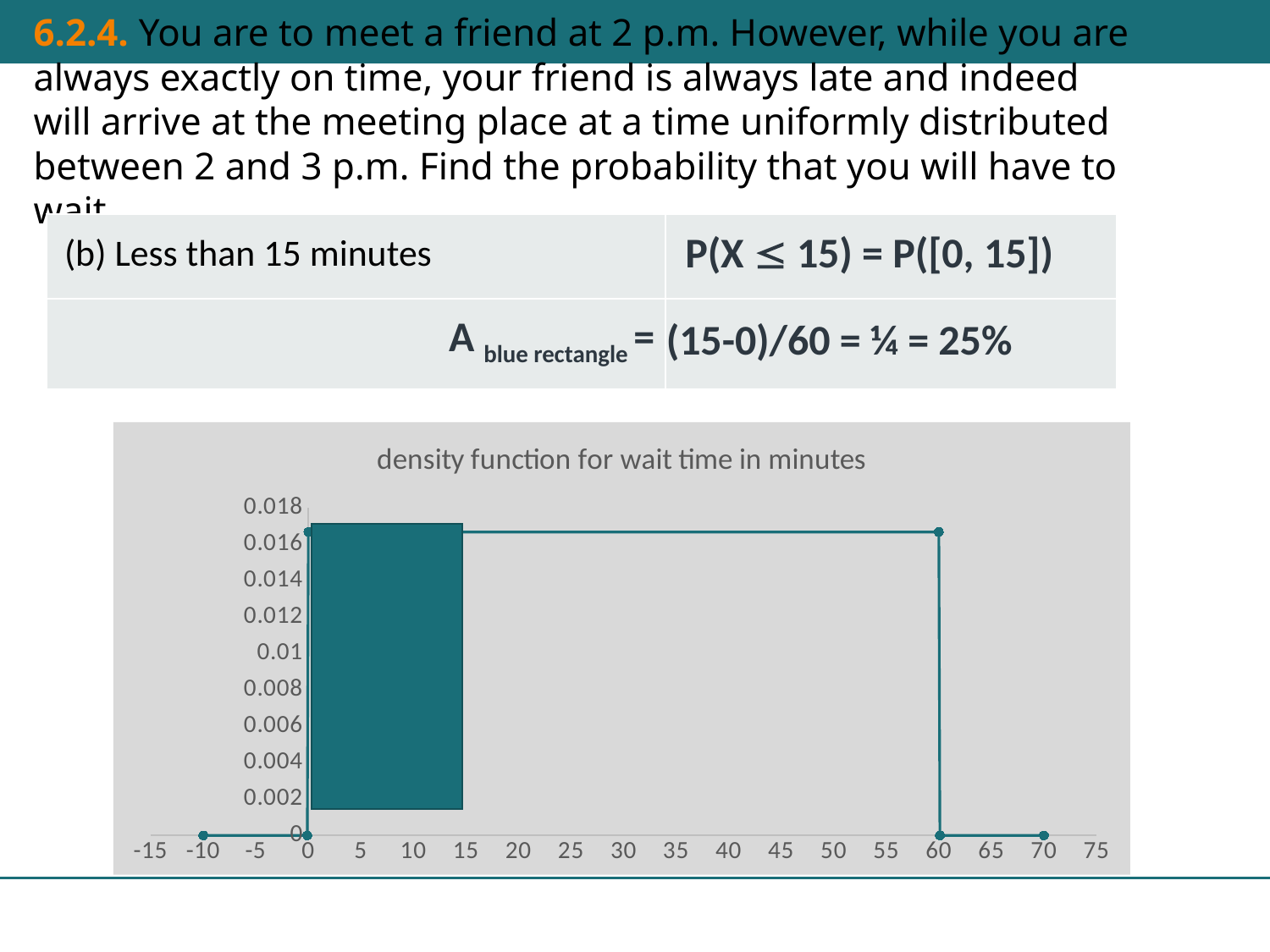
Does the density function rise or fall between x = 60 and x = 70? fall What is the lowest tick label shown on the x axis? -15 Between which two x values does the shaded rectangle extend? 0 and 15 Is the value of the density function at x = 30 greater or less than 0.018? less What kind of chart is shown on the slide? line chart Which is larger, the density value at x = 20 or at x = 65? x = 20 At which x value does the density function drop back to 0 on the right side? 60 What is the value of the density function at x = -10? 0 Is the value of the density function at x = 30 greater or less than 0.01? greater What is the title of the chart? density function for wait time in minutes What is the value of the density function at x = 70? 0 What is the highest tick label shown on the y axis? 0.018